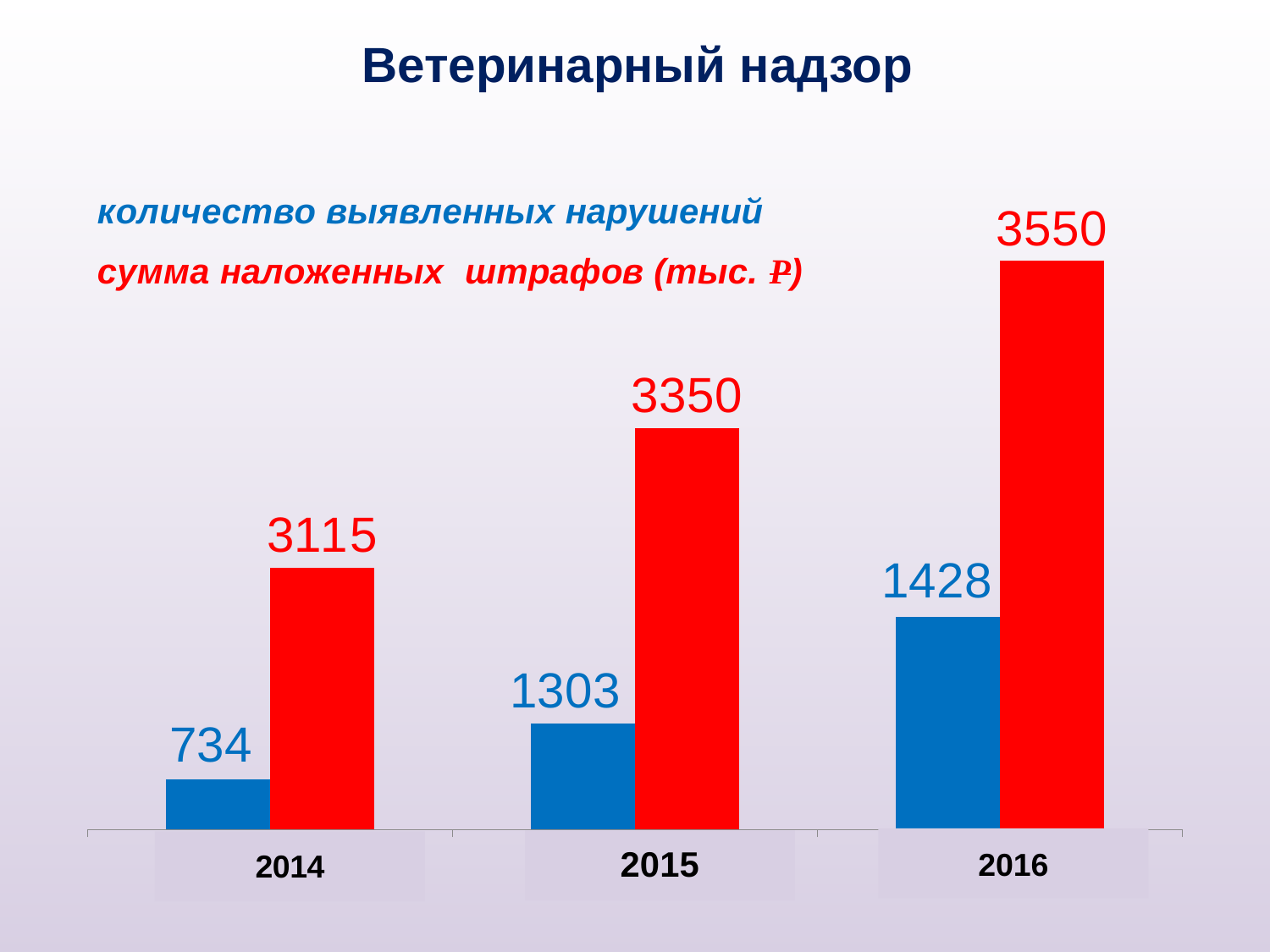
What type of chart is shown on the slide? Bar chart What was the number of detected violations (количество выявленных нарушений) in 2014? 734 In which year was the sum of imposed fines the highest? 2016 What is the difference between the sum of imposed fines in 2015 and in 2014? 235 How many years are shown on the x axis of the chart? 3 How many data series does the chart show? 2 By how much did the number of detected violations increase from 2014 to 2016? 694 In which year was the number of detected violations the lowest? 2014 What was the number of detected violations in 2015? 1303 Does the number of detected violations rise or fall from 2014 to 2016? Rise What was the sum of imposed fines (сумма наложенных штрафов) in 2016? 3550 Which is larger: the sum of imposed fines in 2015 or in 2016? 2016